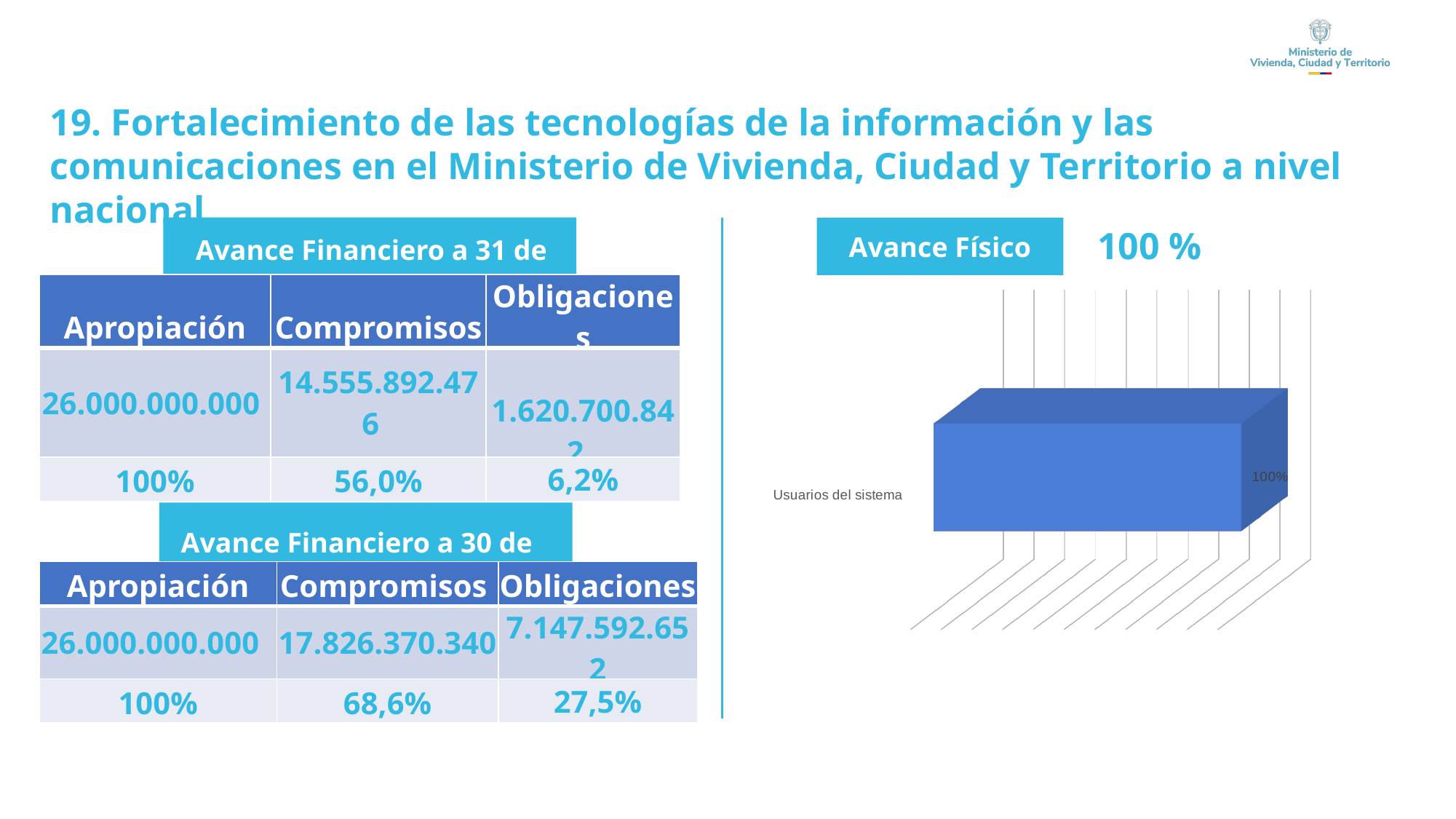
What kind of chart is the Avance Físico chart? bar chart What value is shown for Usuarios del sistema in the Avance Físico chart? 100% What colour is the bar in the Avance Físico chart? blue How many categories are plotted in the Avance Físico chart? 1 What is the name of the category plotted in the Avance Físico chart? Usuarios del sistema